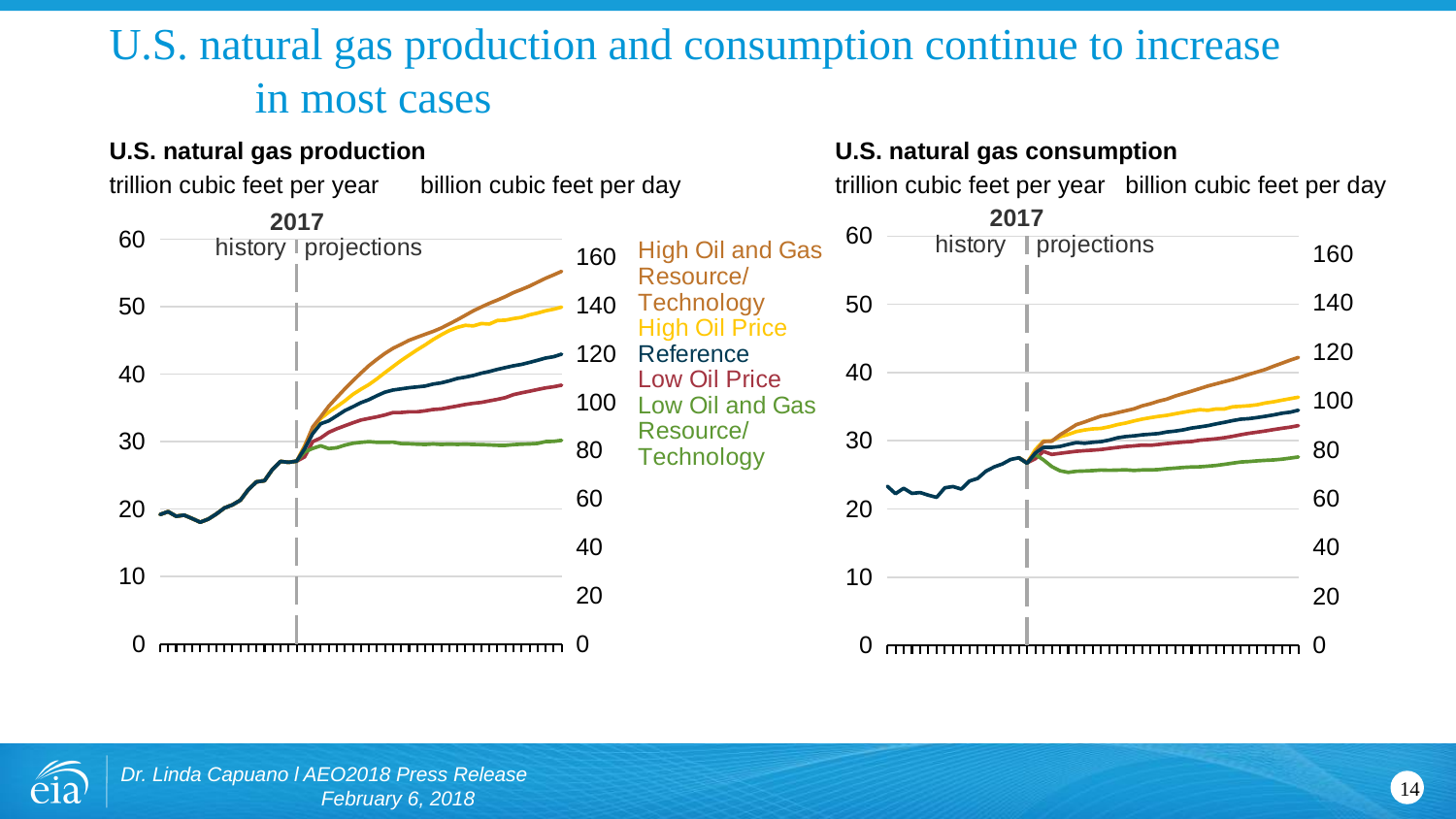
In the U.S. natural gas production chart, does the Reference case rise or fall over the projection period? rise How many scenario series does the legend list for the charts? 5 In the U.S. natural gas consumption chart, which is higher at the end of the projection period: High Oil Price or Low Oil Price? High Oil Price In the U.S. natural gas consumption chart, which scenario has the lowest value at the end of the projection period? Low Oil and Gas Resource/Technology What kind of chart is the U.S. natural gas production chart? line chart In the U.S. natural gas production chart, is the High Oil and Gas Resource/Technology value at the end of the projection period greater or less than 50 trillion cubic feet per year? greater In the U.S. natural gas consumption chart, is the Low Oil and Gas Resource/Technology value at the end of the projection period greater or less than 30 trillion cubic feet per year? less Which year separates history from projections in both charts? 2017 In the U.S. natural gas production chart, is the Reference case value at the end of the projection period greater or less than 40 trillion cubic feet per year? greater In the U.S. natural gas production chart, which scenario has the highest value at the end of the projection period? High Oil and Gas Resource/Technology In the U.S. natural gas production chart, which scenario has the lowest value at the end of the projection period? Low Oil and Gas Resource/Technology In the U.S. natural gas consumption chart, which scenario has the highest value at the end of the projection period? High Oil and Gas Resource/Technology